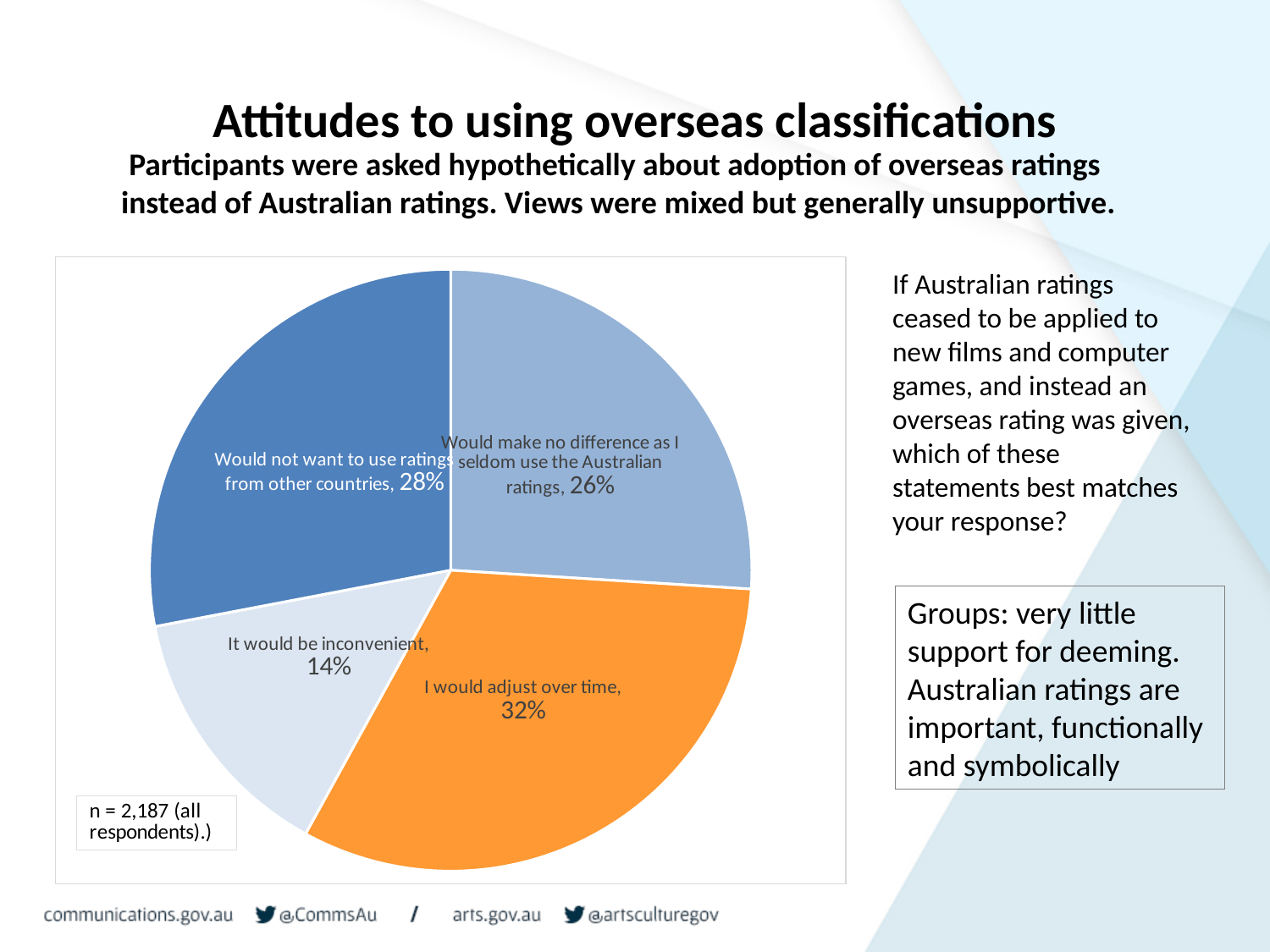
What percentage of respondents said it 'Would make no difference as I seldom use the Australian ratings'? 26% What percentage of respondents said they 'Would not want to use ratings from other countries'? 28% Which is larger: the share for 'Would not want to use ratings from other countries' or the share for 'Would make no difference as I seldom use the Australian ratings'? Would not want to use ratings from other countries What is the difference in percentage points between 'I would adjust over time' and 'It would be inconvenient'? 18 How many slices does the pie chart have? 4 What percentage of respondents said 'I would adjust over time'? 32% What colour is the 'I would adjust over time' slice? orange Which response has the largest share of the pie? I would adjust over time Which response has the smallest share of the pie? It would be inconvenient What kind of chart is shown on the slide? pie chart What is the sample size (n) stated on the chart? n = 2,187 (all respondents) What percentage of respondents said 'It would be inconvenient'? 14%